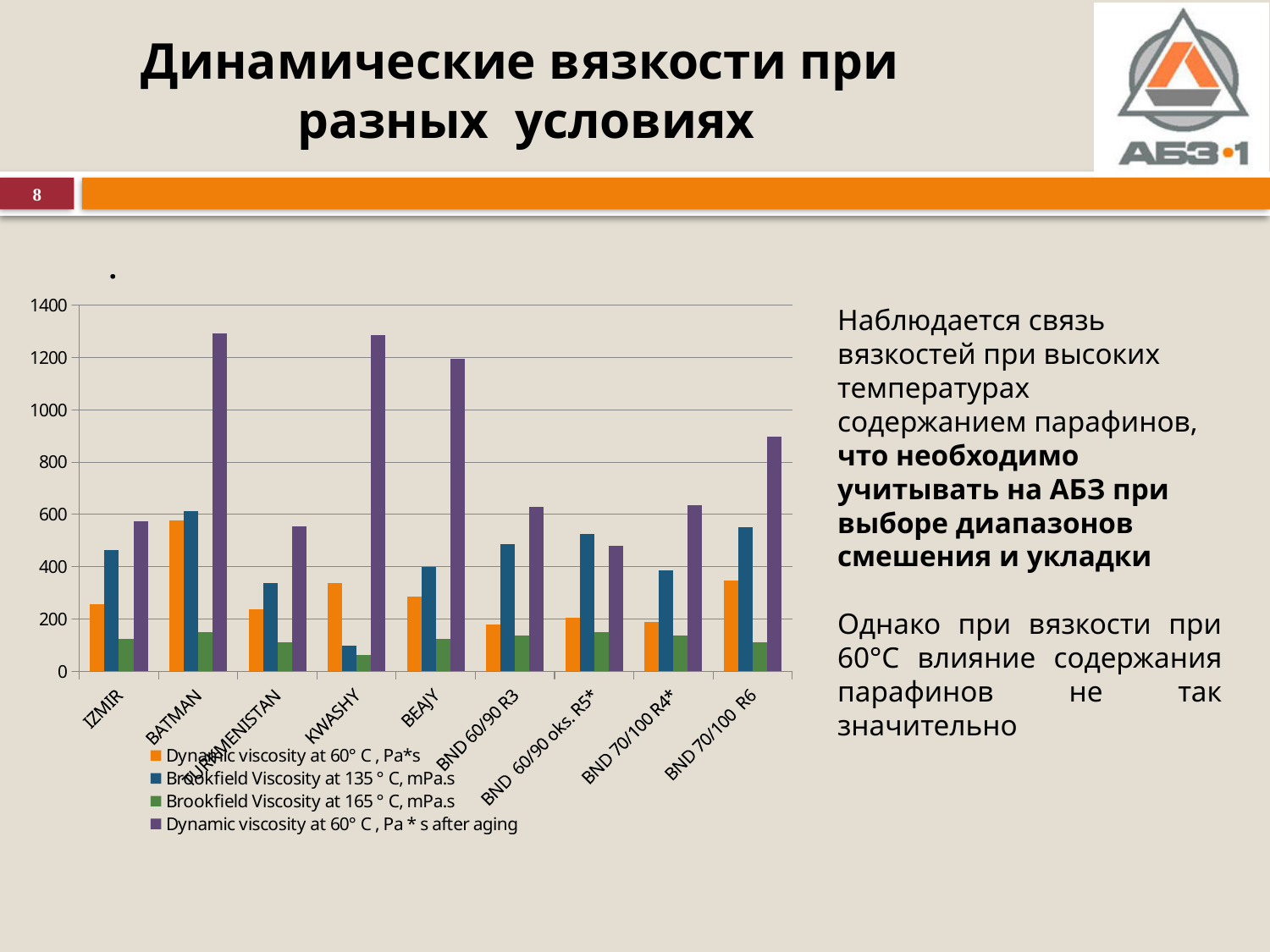
Is the value of 'Dynamic viscosity at 60° C, Pa * s after aging' for KWASHY greater or less than 1200? greater Is the value of 'Dynamic viscosity at 60° C, Pa * s after aging' for BND 70/100 R6 greater or less than 1000? less Which is larger: the 'Dynamic viscosity at 60° C, Pa*s' value for BATMAN or for IZMIR? BATMAN Which series in the legend is shown in purple? Dynamic viscosity at 60° C, Pa * s after aging Is the value of 'Brookfield Viscosity at 135 ° C, mPa.s' for KWASHY greater or less than 200? less Which category has the lowest value for 'Dynamic viscosity at 60° C, Pa * s after aging'? BND 60/90 oks. R5* Which is larger: the 'Brookfield Viscosity at 135 ° C, mPa.s' value for BATMAN or for KWASHY? BATMAN What kind of chart is shown on the slide? bar chart How many series does the chart's legend list? 4 How many categories are shown along the x axis of the chart? 9